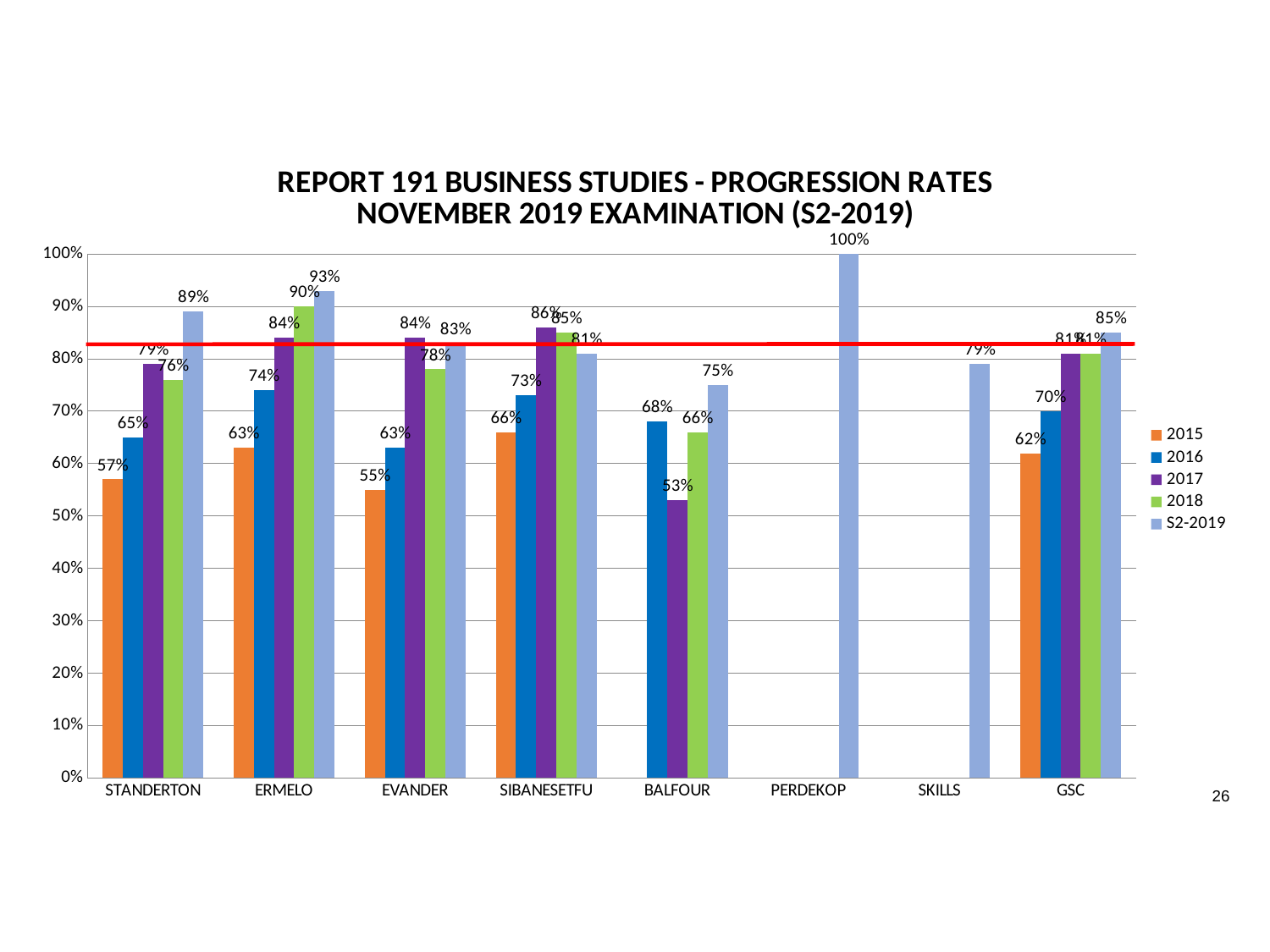
How many series does the legend list? 5 What is the difference between the S2-2019 and 2015 values for ERMELO? 30 percentage points What kind of chart is shown on the slide? Bar chart Which campus has the lowest 2017 progression rate? BALFOUR For EVANDER, which is larger: the 2017 value or the 2018 value? 2017 What is the S2-2019 progression rate for ERMELO? 93% What is the 2015 progression rate for STANDERTON? 57% How many campuses are shown on the x axis? 8 What is the S2-2019 value for SKILLS? 79% Which campus has the highest S2-2019 progression rate? PERDEKOP What is the 2016 value for BALFOUR? 68% What is the 2016 value for GSC? 70%